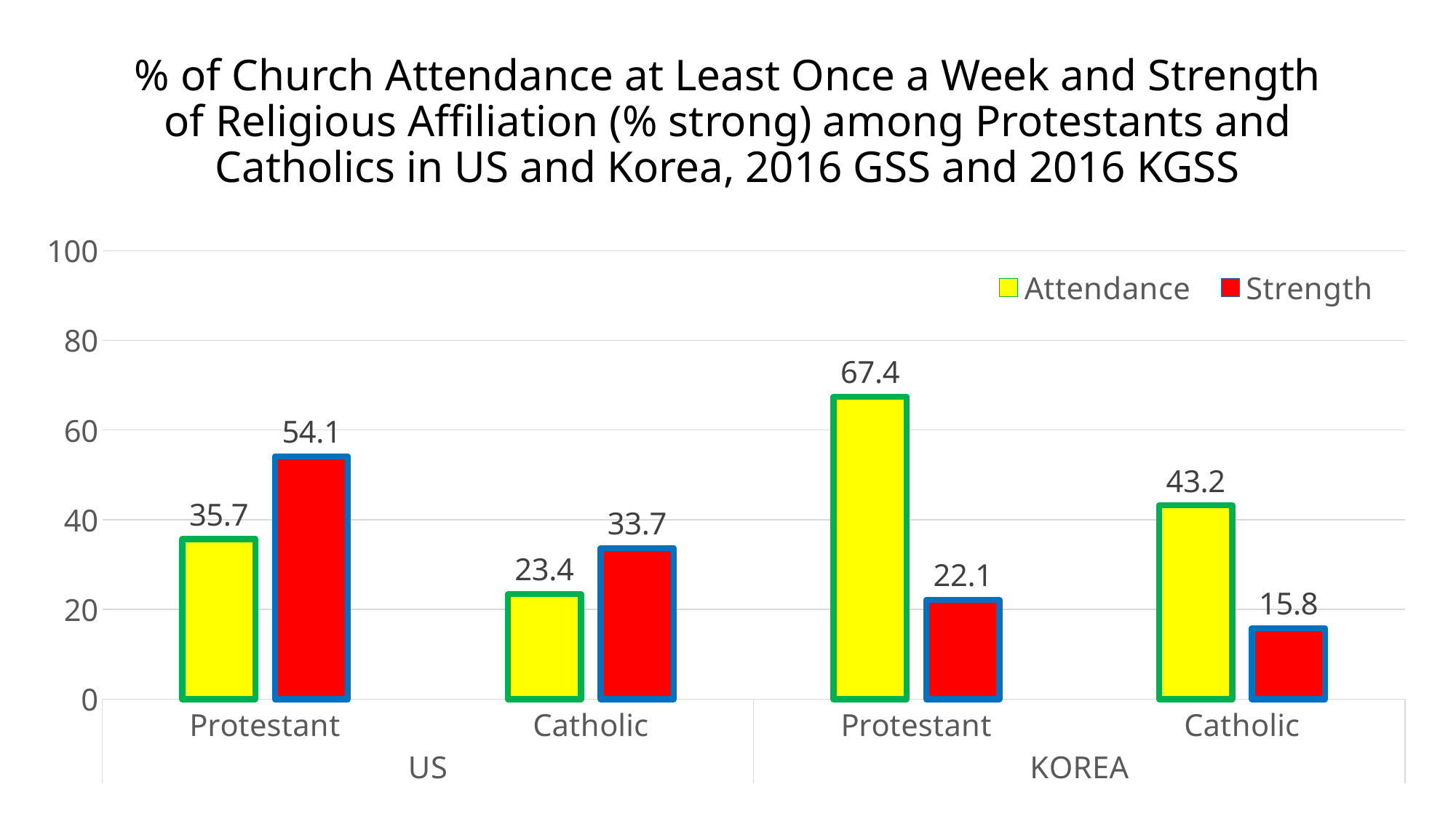
Is the Attendance value for Catholics in Korea greater or less than 40? greater What is the Strength value for Catholics in Korea? 15.8 Which group has the lowest Strength value? Catholic (KOREA) What kind of chart is shown on the slide? Bar chart Which is larger for Catholics in the US: Attendance or Strength? Strength What is the Strength value for Protestants in the US? 54.1 What is the difference between the Attendance values for Protestants in Korea and Protestants in the US? 31.7 How many series does the legend list? 2 Which group has the highest Attendance value? Protestant (KOREA) How many groups (bar pairs) are shown on the x axis? 4 What is the Attendance value for Protestants in the US? 35.7 What colour represents the Strength series? Red